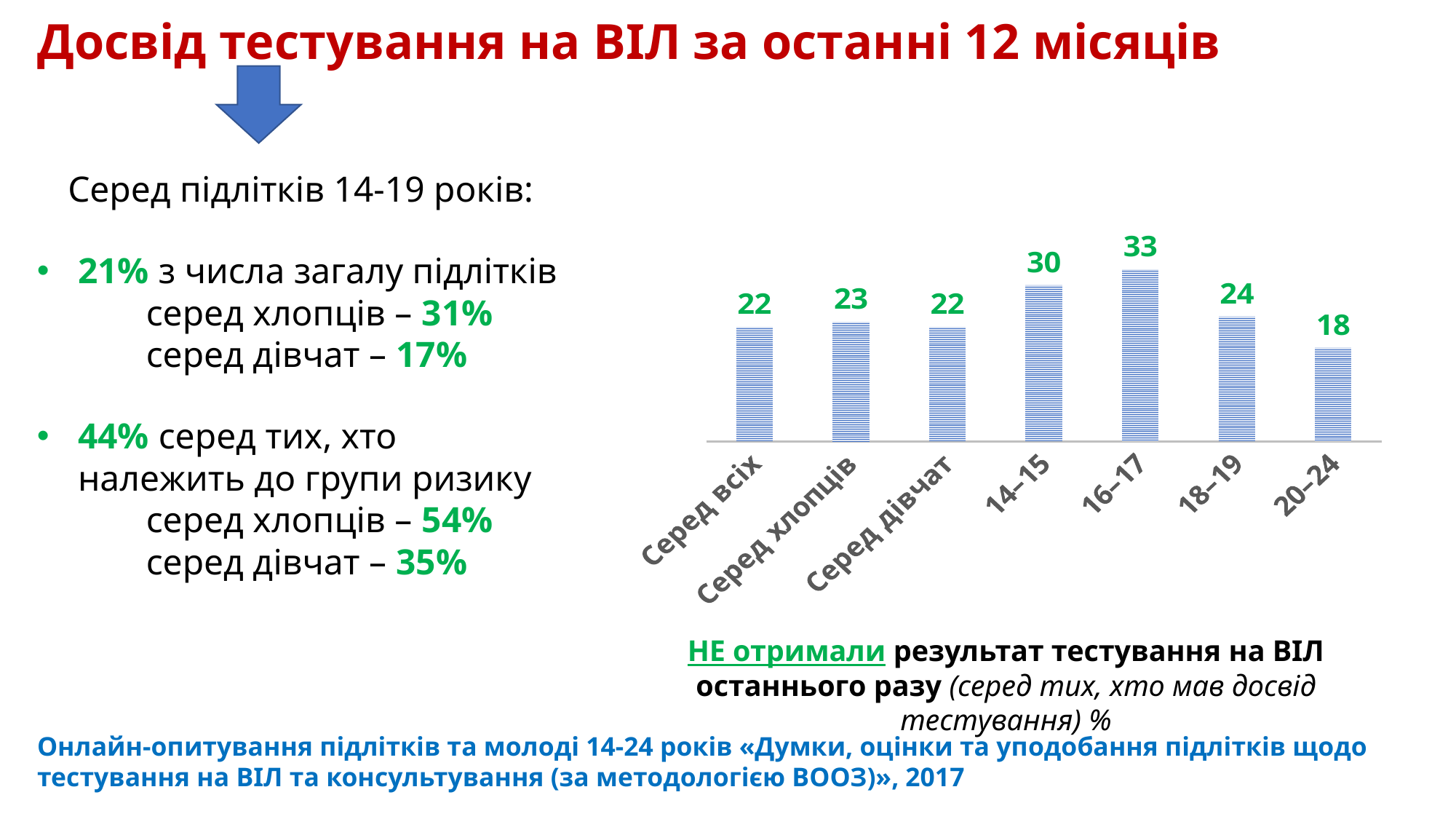
What is the difference between the values for 16–17 and 20–24? 15 Which category has the lowest value in the chart? 20–24 What is the value for the 16–17 age group in the chart? 33 What is the value for 'Серед хлопців' in the chart? 23 What kind of chart is shown on the slide? Bar chart How many categories are shown in the chart? 7 Which is larger, the value for 'Серед хлопців' or 'Серед дівчат'? Серед хлопців Which category has the highest value in the chart? 16–17 Do the values rise or fall from the 16–17 group to the 20–24 group? Fall What is the value for the 20–24 age group in the chart? 18 What is the difference between the values for 14–15 and 18–19? 6 What is the value for 'Серед всіх' in the chart? 22